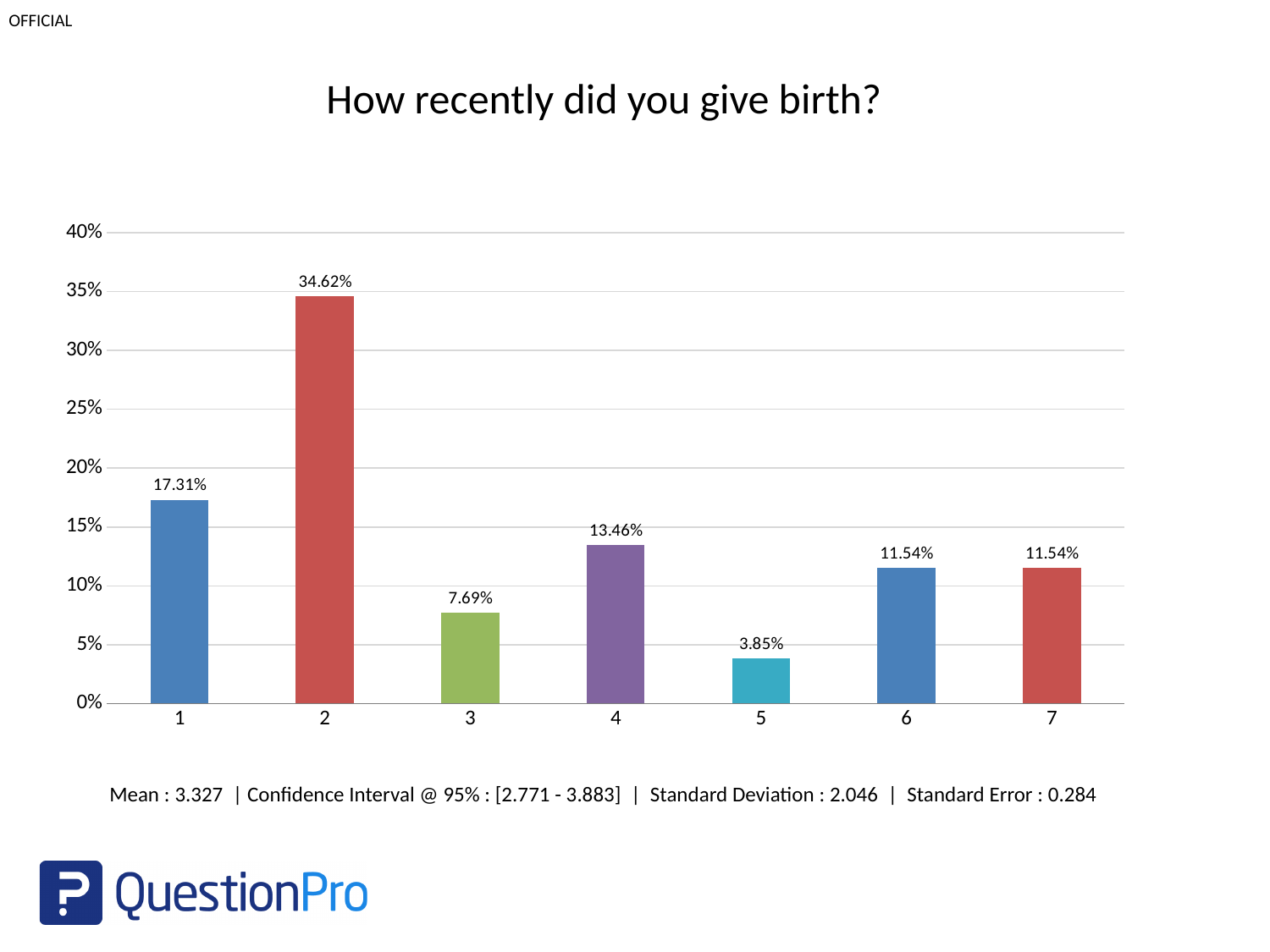
What is the value for category 5? 3.85% What is the value for category 1? 17.31% What is the difference between the values for category 4 and category 3? 5.77% Which category has the lowest value? 5 What is the difference between the values for category 2 and category 1? 17.31% Is the value for category 2 greater or less than 30%? greater What is the value for category 2? 34.62% Which category has the highest value? 2 Which is larger, the value for category 3 or the value for category 4? 4 How many categories are shown on the x axis? 7 What is the title of the chart? How recently did you give birth? What kind of chart is shown on the slide? bar chart